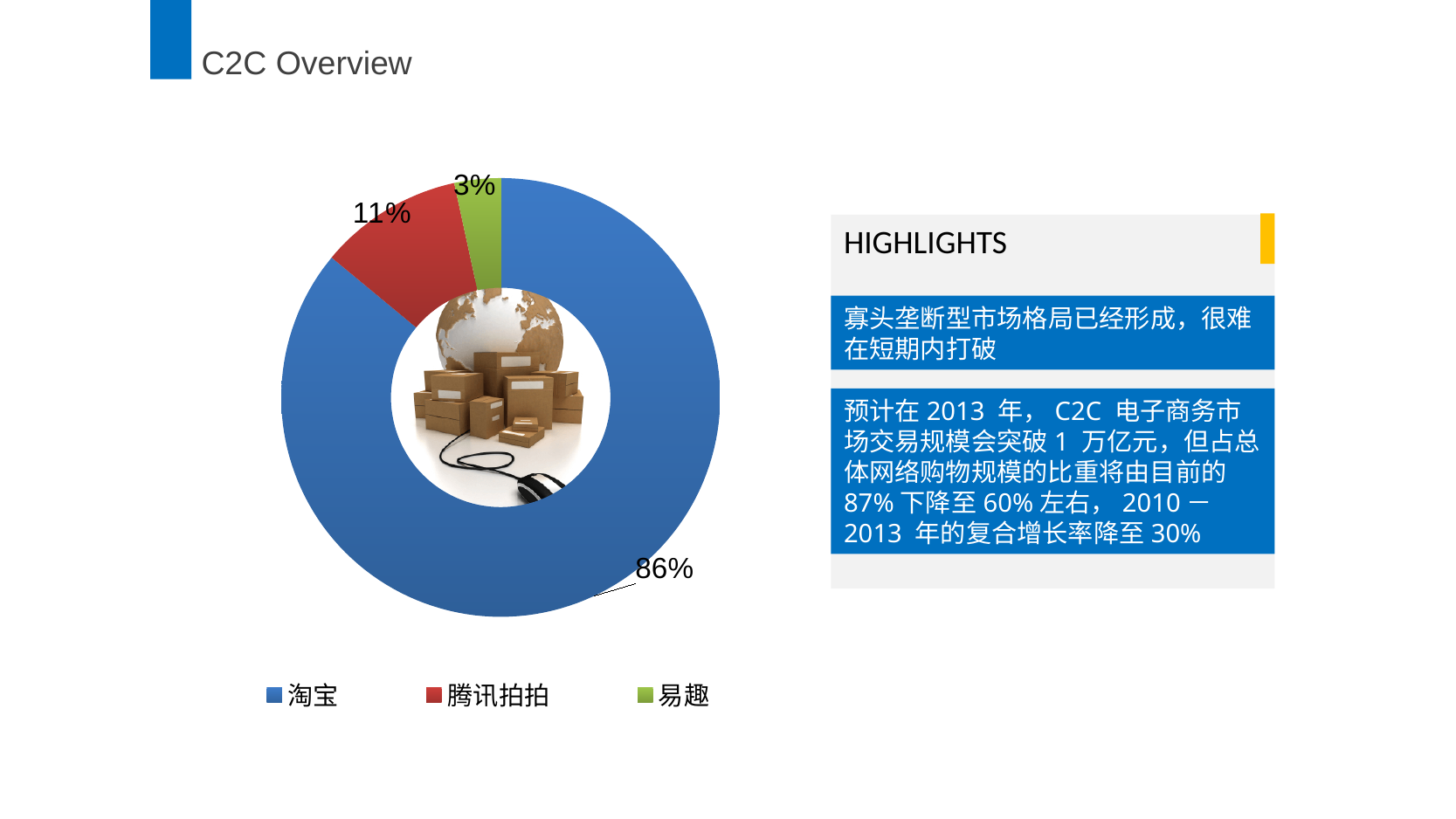
What share of the pie does 易趣 hold? 3% How many categories are shown in the chart? 3 What colour represents 腾讯拍拍 in the chart? Red Which has a larger share, 腾讯拍拍 or 易趣? 腾讯拍拍 What share of the pie does 腾讯拍拍 hold? 11% What kind of chart is shown on the slide? Pie chart (doughnut) How many entries does the legend list? 3 What share of the pie does 淘宝 hold? 86% What is the difference in percentage points between the shares of 腾讯拍拍 and 易趣? 8 Which category has the largest share of the pie? 淘宝 What is the difference in percentage points between the shares of 淘宝 and 腾讯拍拍? 75 Which category has the smallest share of the pie? 易趣